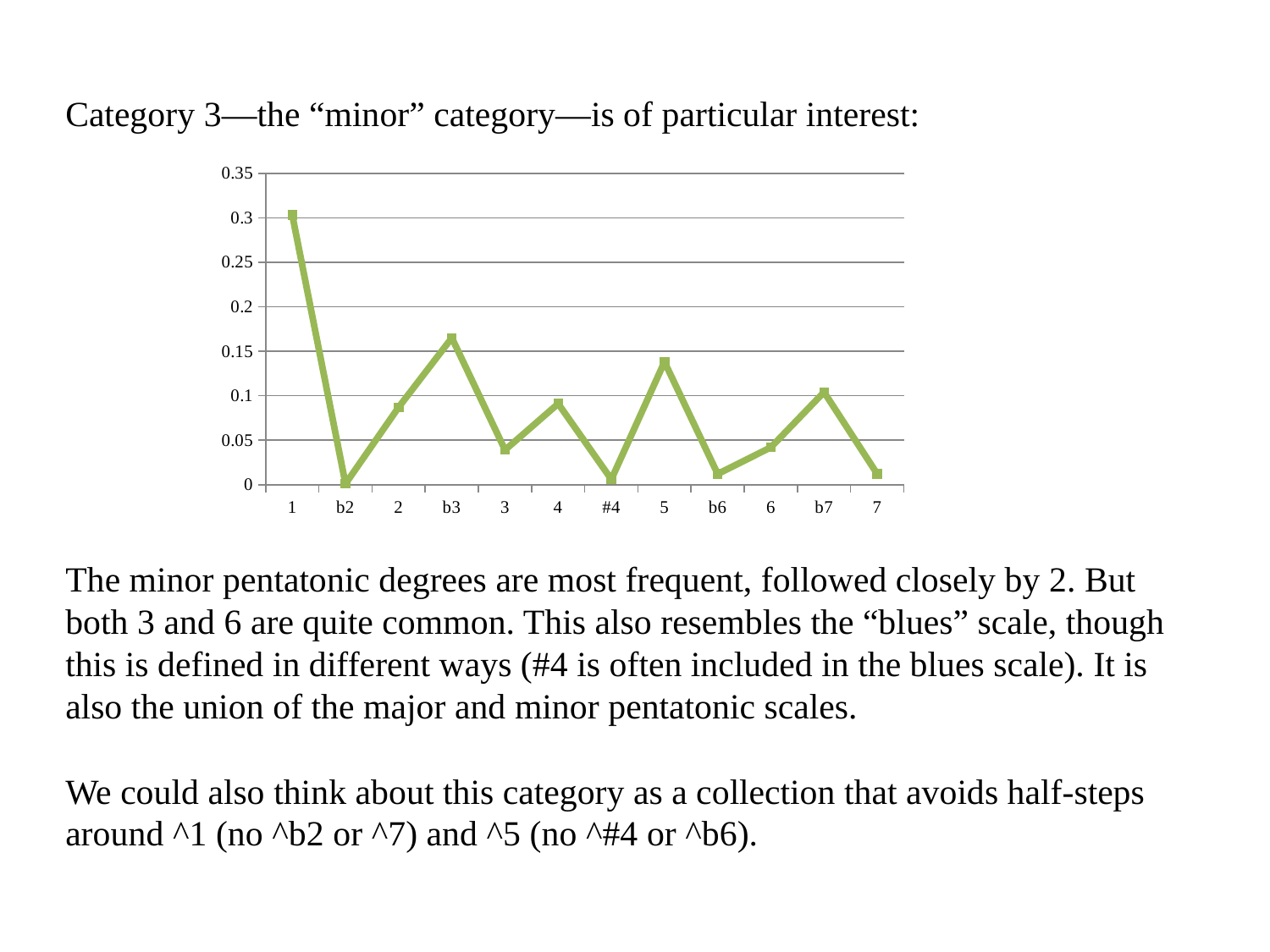
What kind of chart is shown on the slide? line chart What is the highest value shown on the y axis of the chart? 0.35 Which scale degree has the highest value in the chart? 1 Is the value for scale degree 1 greater or less than 0.25? greater Which has the larger value, b3 or 5? b3 How many scale degrees are plotted along the x axis of the chart? 12 Is the value for scale degree 5 greater or less than 0.15? less Is the value for scale degree 3 greater or less than 0.05? less Which has the larger value, 5 or b7? 5 Does the line rise or fall from scale degree 1 to b2? fall